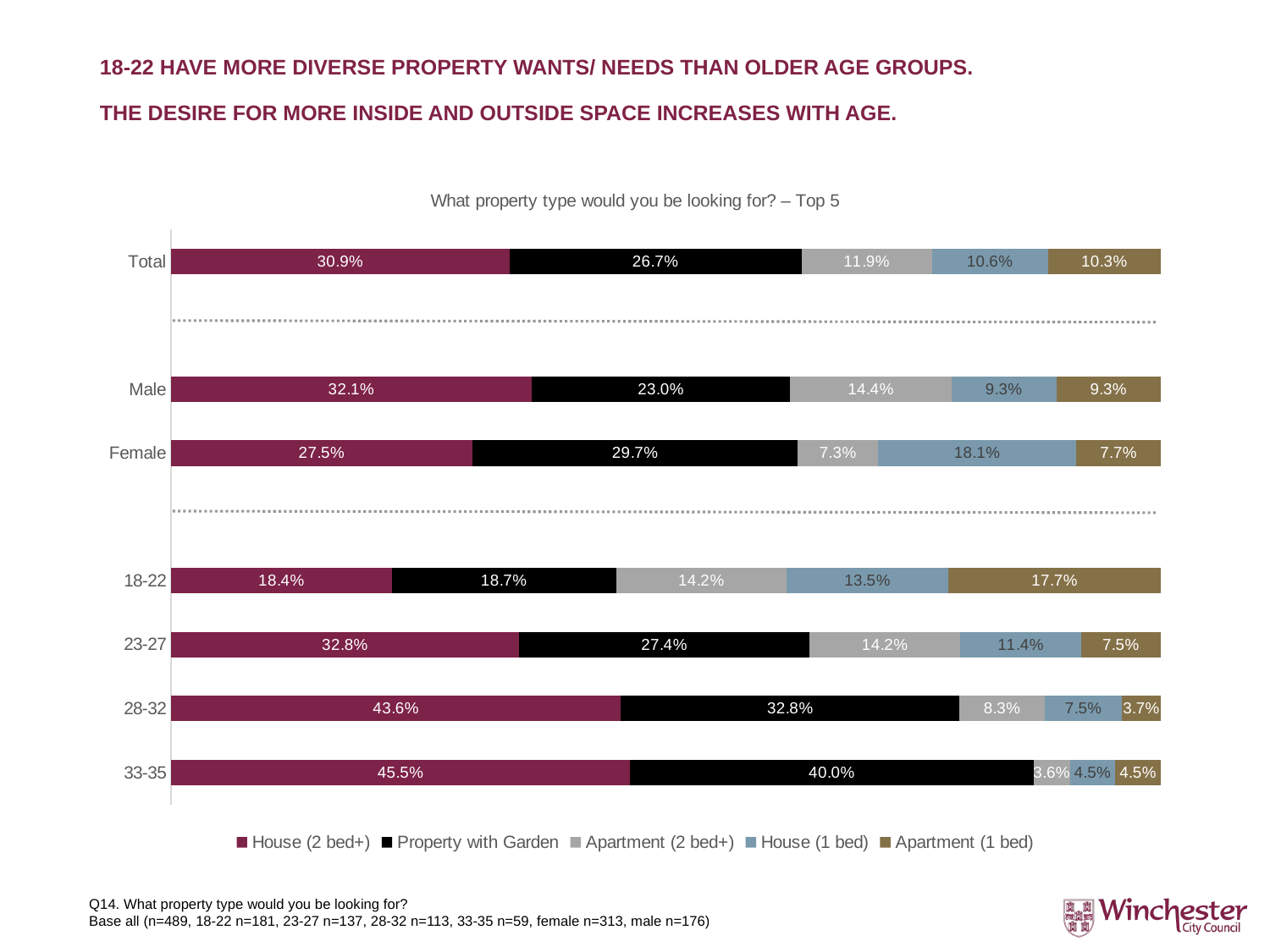
How many series does the legend list? 5 How many categories (bars) are shown in the chart? 7 What kind of chart is shown on the slide? Stacked bar chart What is the value for House (2 bed+) in the Total bar? 30.9% What is the Property with Garden value for the 33-35 age group? 40.0% What is the difference between the Male and Female values for House (2 bed+)? 4.6 percentage points What is the total of the stacked bar for the 18-22 age group? 82.5% What percentage of Female respondents want a House (1 bed)? 18.1% Which is larger for Property with Garden, Male or Female? Female Which age group has the lowest value for House (2 bed+)? 18-22 Does the House (2 bed+) value rise or fall as the age groups go from 18-22 to 33-35? Rise Which age group has the highest value for House (2 bed+)? 33-35